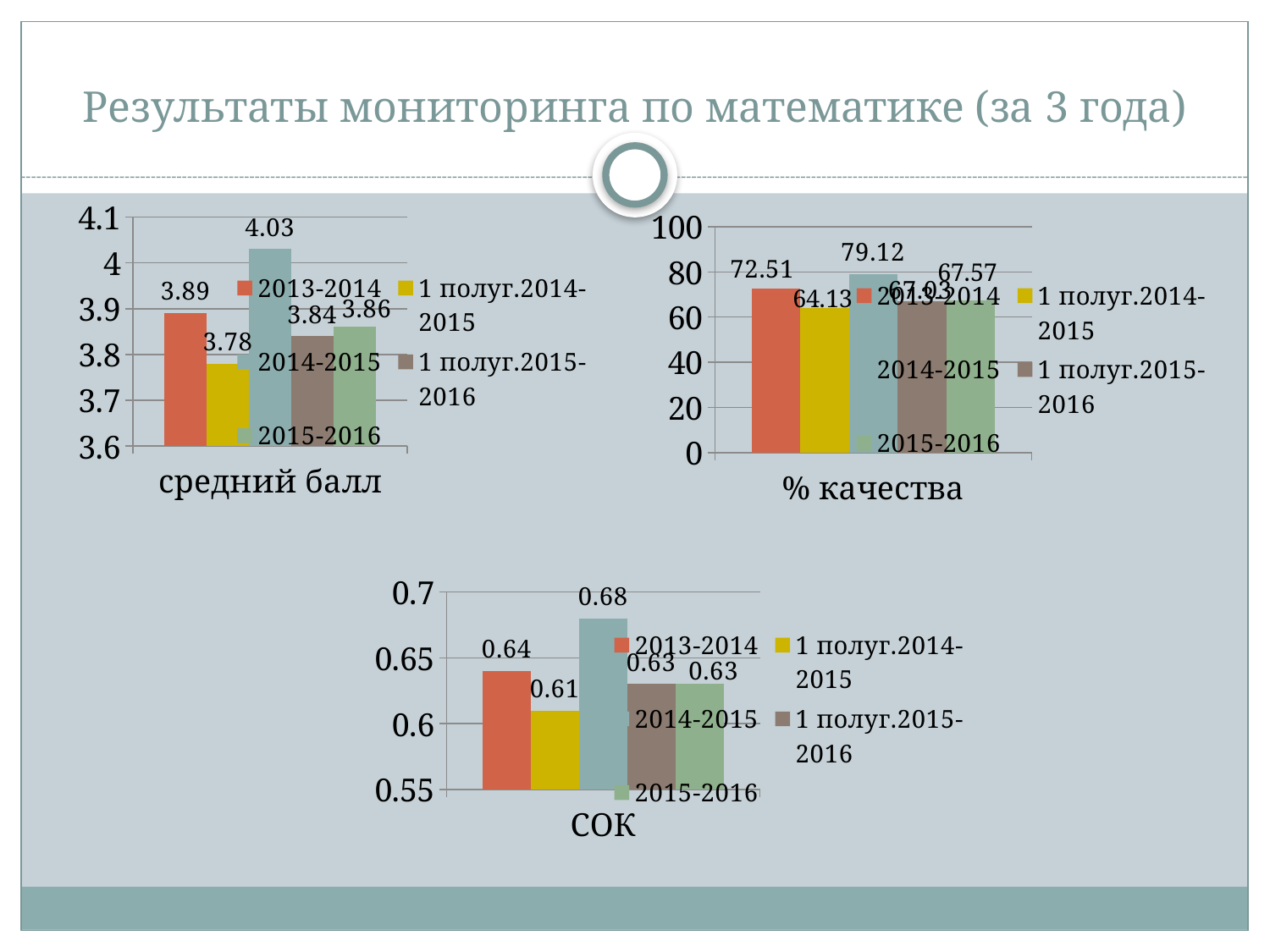
In the chart titled "средний балл", what is the value for 2014-2015? 4.03 In the chart titled "средний балл", which series has the highest value? 2014-2015 In the chart titled "% качества", which is larger: the value for 2013-2014 or the value for 2015-2016? 2013-2014 In the chart titled "% качества", which series has the lowest value? 1 полуг.2014-2015 In the chart titled "средний балл", what is the difference between the 2013-2014 value and the 2015-2016 value? 0.03 In the chart titled "СОК", what is the value for 2014-2015? 0.68 How many series does the legend of the chart titled "СОК" list? 5 In the chart titled "средний балл", what is the value for 1 полуг.2014-2015? 3.78 In the chart titled "% качества", is the value for 2014-2015 greater or less than 80? less In the chart titled "% качества", what is the value for 2013-2014? 72.51 In the chart titled "СОК", what is the difference between the 2014-2015 value and the 1 полуг.2014-2015 value? 0.07 What type of chart is the chart titled "средний балл"? bar chart